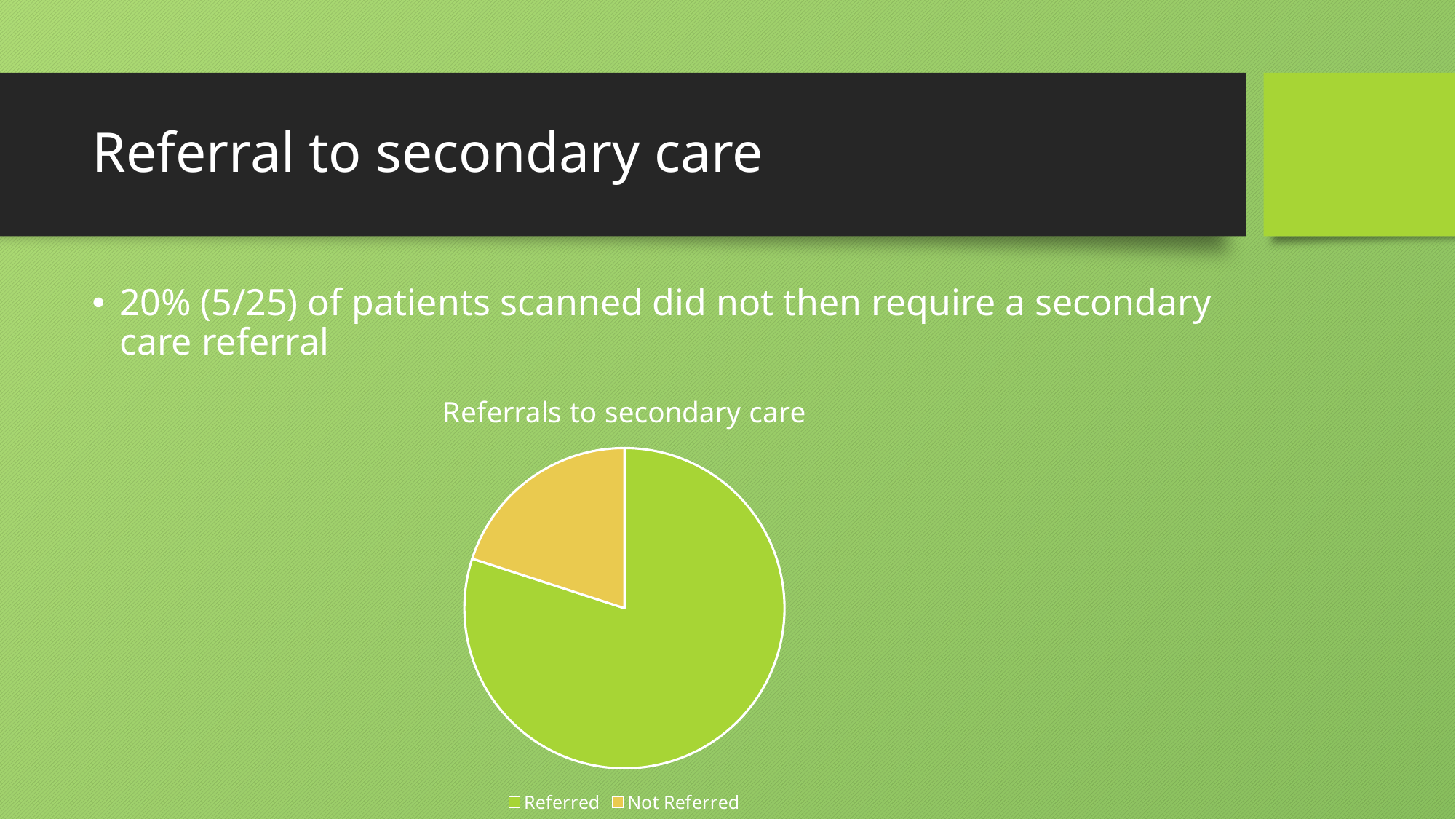
What kind of chart is shown on the slide? pie chart How many slices does the pie chart have? 2 How many entries does the chart legend list? 2 Which slice of the pie chart is the largest? Referred Which slice of the pie chart is the smallest? Not Referred Which is larger in the pie chart, Referred or Not Referred? Referred What colour is the Not Referred slice in the pie chart? yellow What is the title of the chart? Referrals to secondary care